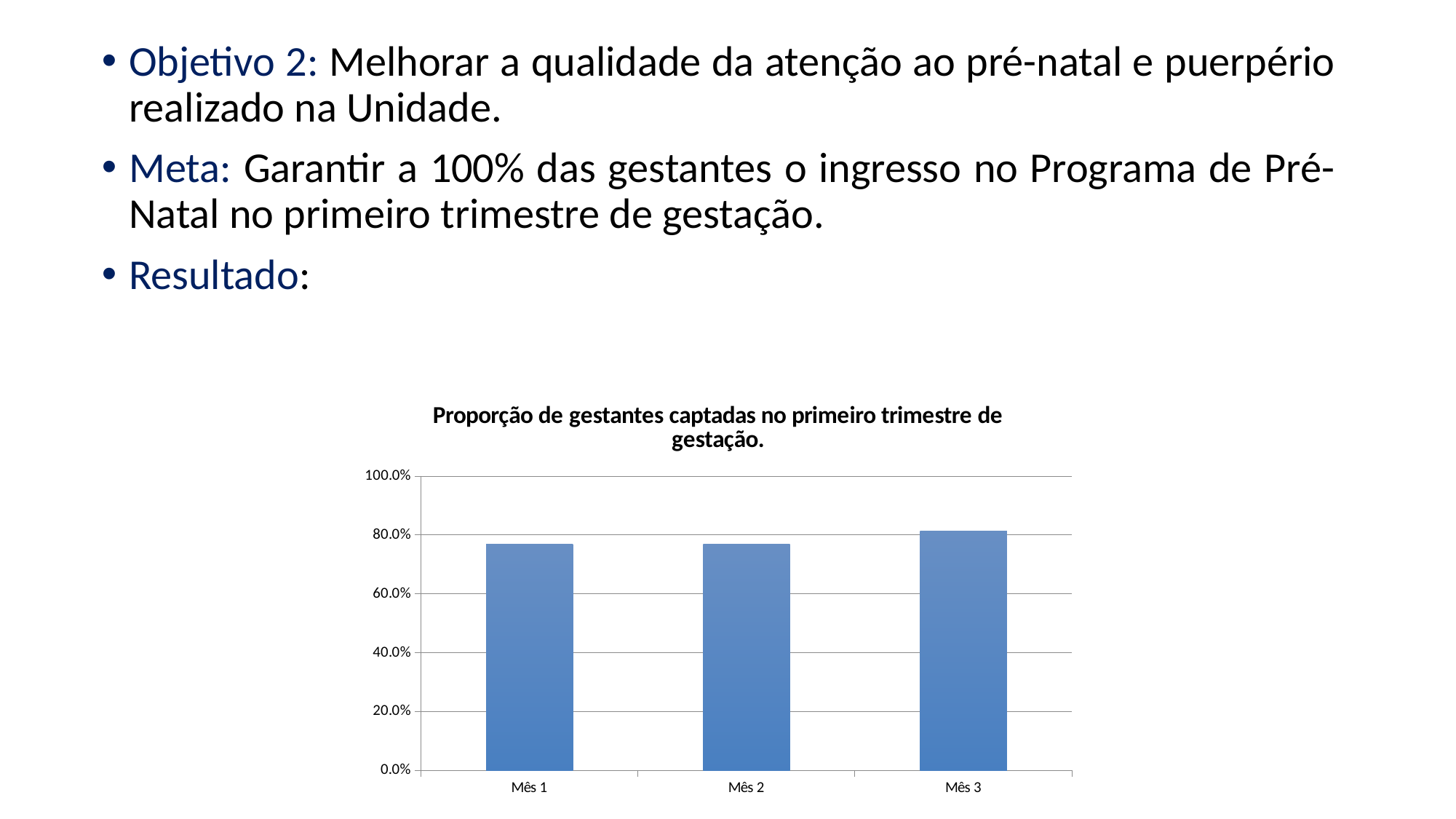
What is the highest value shown on the chart's vertical axis? 100.0% Is the value for Mês 3 greater or less than 100.0%? less How many months (categories) are plotted on the chart? 3 Which month has the highest proportion of pregnant women captured in the first trimester? Mês 3 Is the value for Mês 1 greater or less than 80.0%? less Which is larger, the value for Mês 3 or the value for Mês 1? Mês 3 Which is larger, the value for Mês 2 or the value for Mês 3? Mês 3 Is the value for Mês 1 greater or less than 40.0%? greater What kind of chart is shown on the slide? bar chart What is the title of the chart? Proporção de gestantes captadas no primeiro trimestre de gestação.